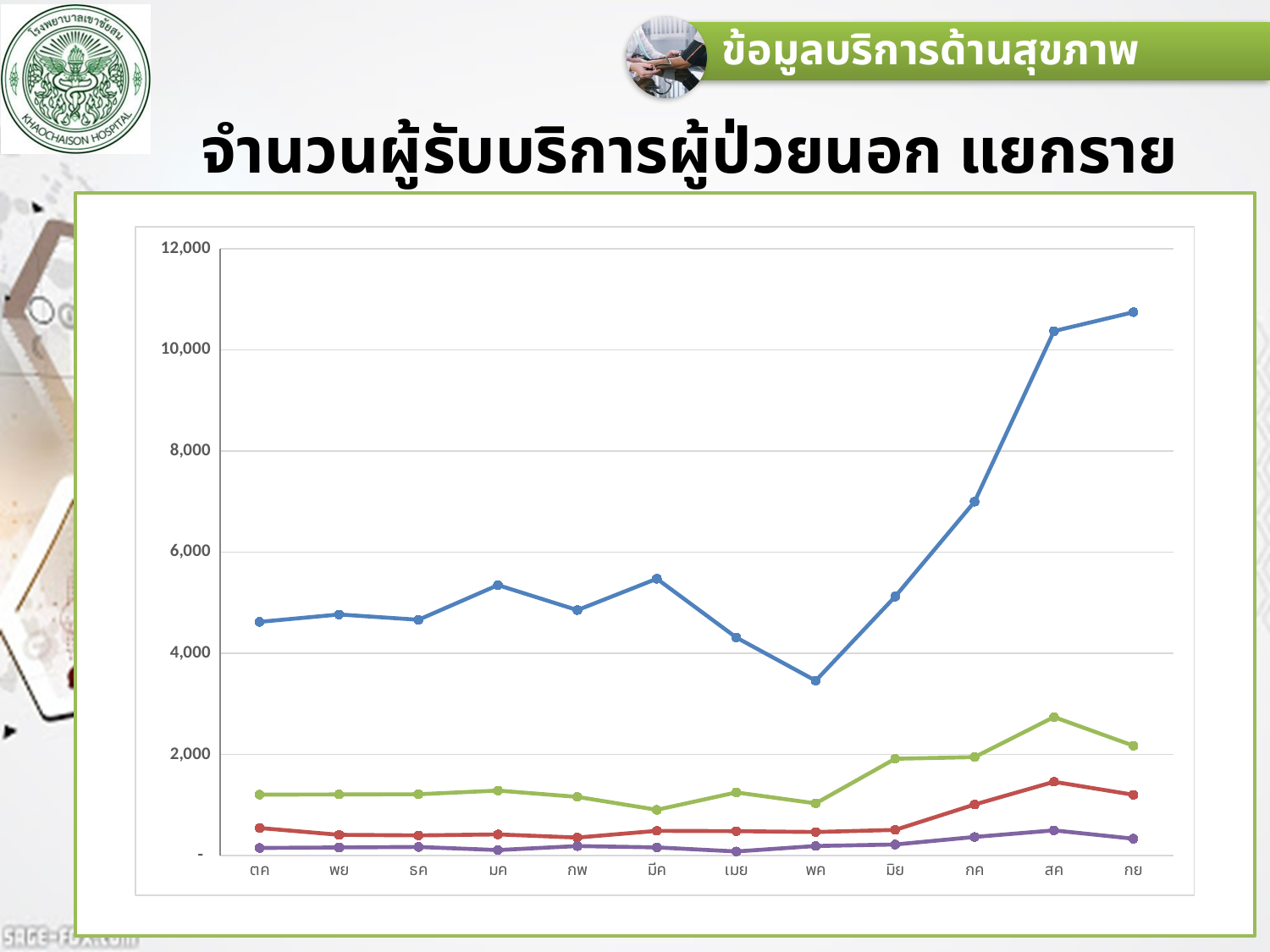
What kind of chart is shown on the slide? line chart How many lines are plotted on the chart? 4 Does the blue line rise or fall from พค to กย? rise At which month does the green line reach its highest value? สค Is the value of the blue line at พค greater or less than 4,000? less Is the value of the blue line at สค greater or less than 10,000? greater Is the value of the green line at สค greater or less than 2,000? greater At which month does the blue line reach its highest value? กย At กย, which line has the larger value, the blue line or the green line? blue How many categories (months) are shown along the x axis? 12 At which month does the blue line reach its lowest value? พค